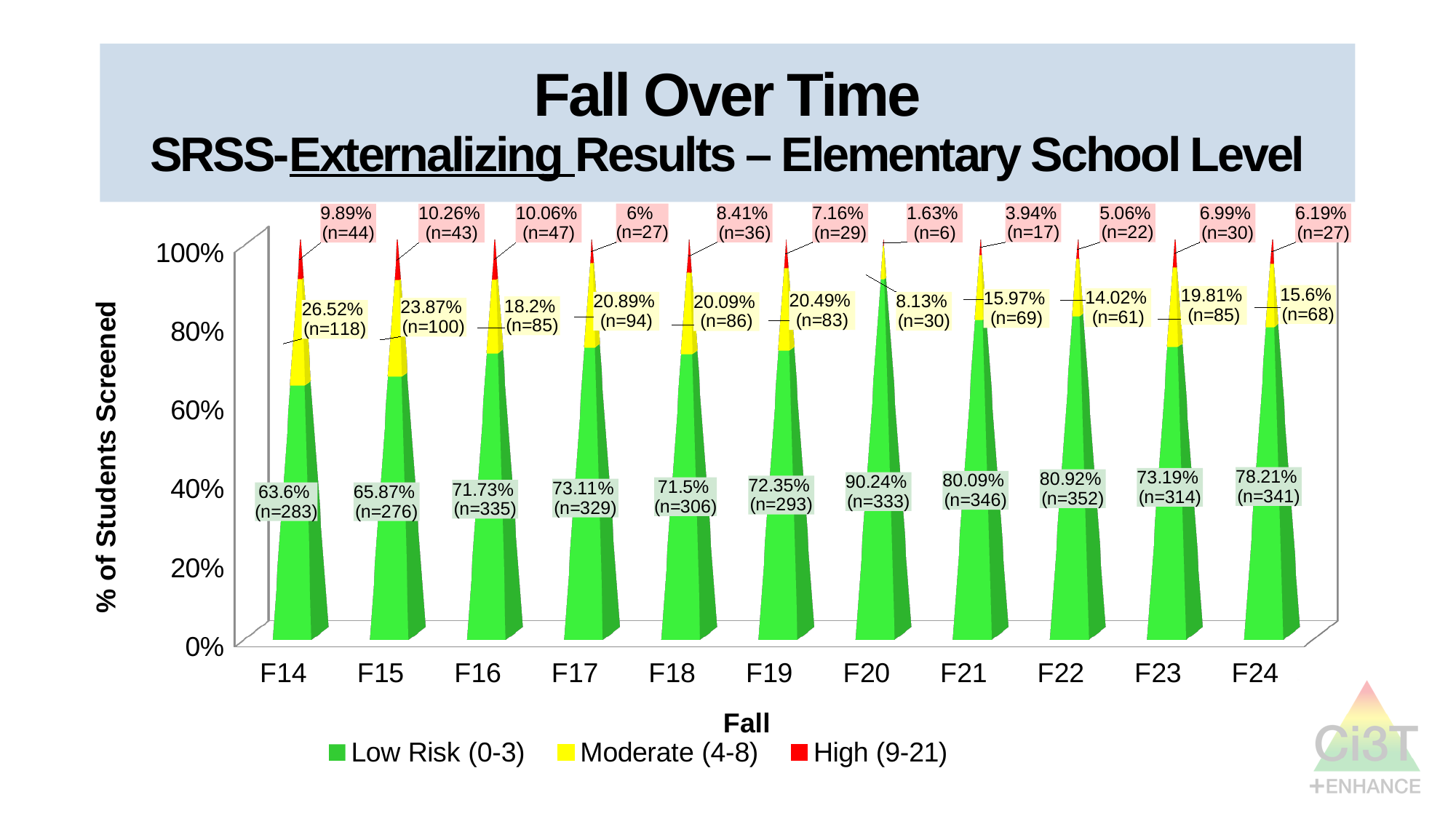
What is the difference in the Low Risk (0-3) percentage between F20 and F14? 26.64% How many students were in the Moderate (4-8) category in F17? n=94 What percentage of students screened were Low Risk (0-3) in F20? 90.24% Is the Low Risk (0-3) value for F20 greater or less than 80%? greater Which fall had the lowest percentage of Low Risk (0-3) students? F14 Which fall had the highest percentage of Low Risk (0-3) students? F20 How many fall screening periods are shown on the x axis? 11 How many series does the legend list? 3 What percentage of students screened were High (9-21) in F15? 10.26% Which fall had a larger Moderate (4-8) percentage, F14 or F24? F14 Which fall had the lowest percentage of High (9-21) students? F20 What kind of chart is shown on the slide? Stacked bar chart